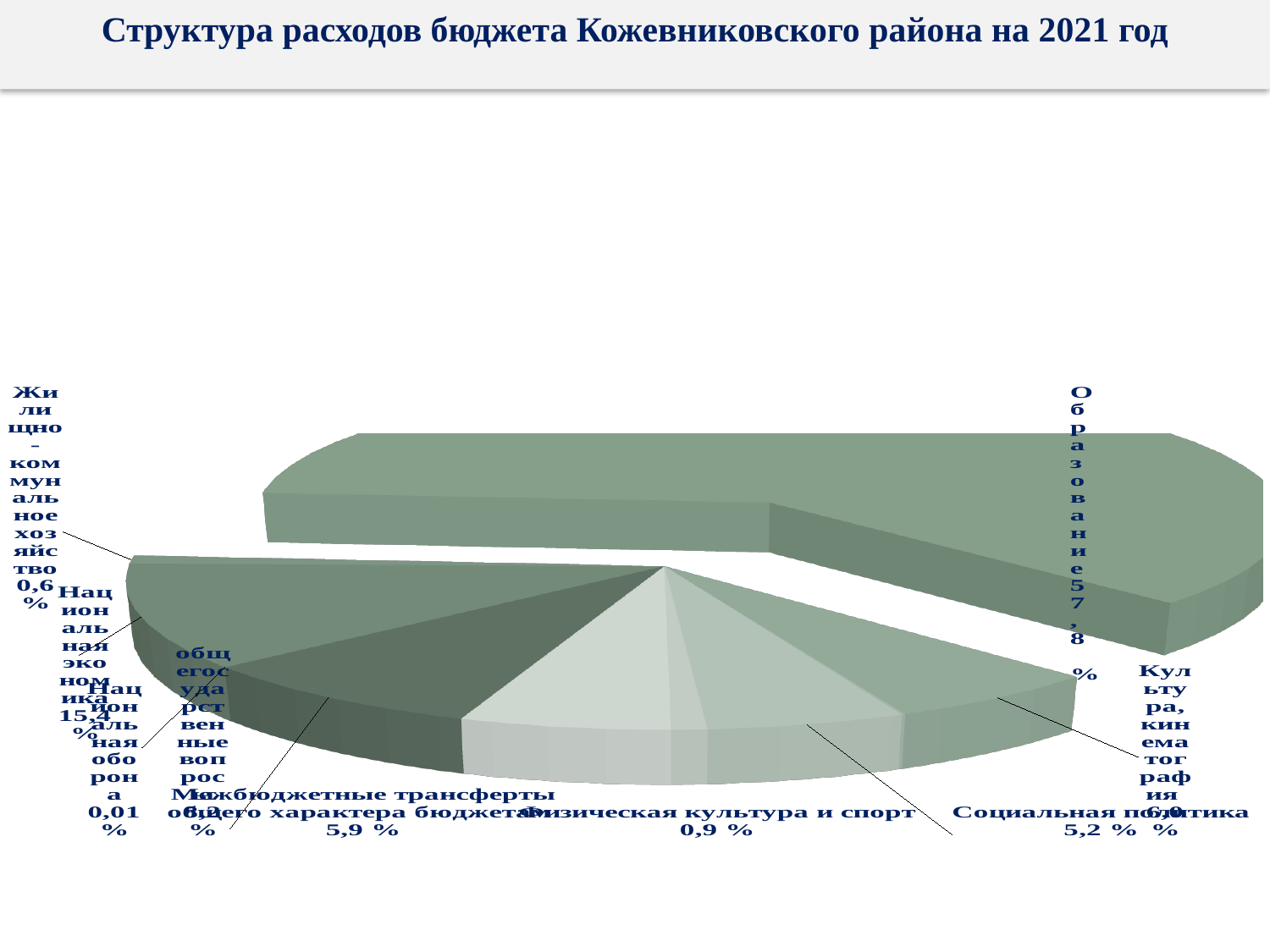
What share of the budget expenditure goes to Жилищно-коммунальное хозяйство? 0,6 % What share of the budget expenditure goes to Физическая культура и спорт? 0,9 % Which expenditure category has the smallest share of the budget? Национальная оборона What share of the budget expenditure goes to Образование? 57,8 % Which has a larger share: Социальная политика or Культура, кинематография? Культура, кинематография What kind of chart is shown on the slide? pie chart What share of the budget expenditure goes to Социальная политика? 5,2 % What share of the budget expenditure goes to Культура, кинематография? 6,0 % What is the title of the chart? Структура расходов бюджета Кожевниковского района на 2021 год What share of the budget expenditure goes to Национальная экономика? 15,4 % How many percentage points larger is the share of Образование than the share of Национальная экономика? 42,4 % Which expenditure category has the largest share of the budget? Образование